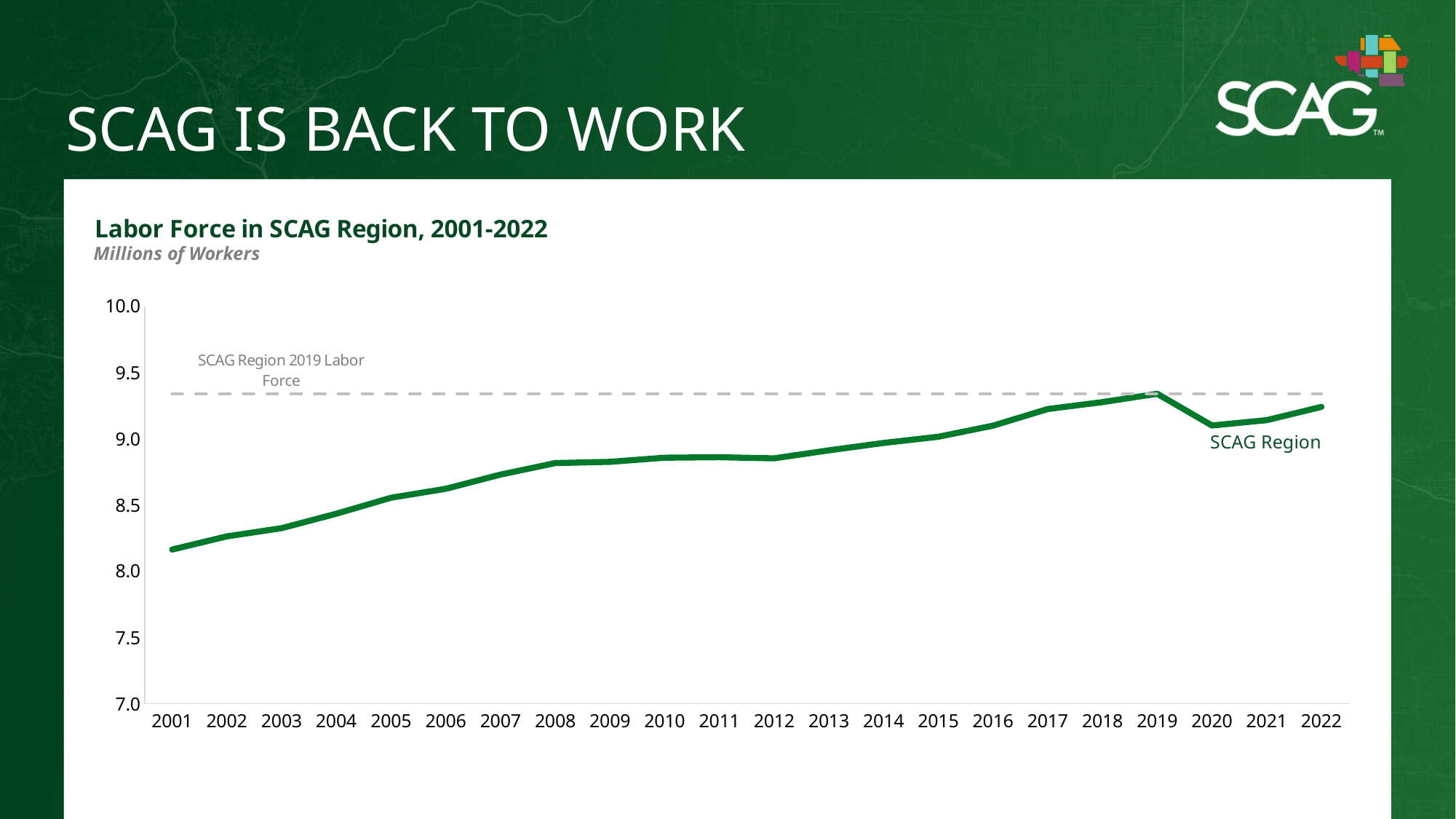
What kind of chart is shown on the slide? line chart Is the value for 2019 greater or less than 9.0? greater Which year has the larger labor force, 2019 or 2020? 2019 How many years are shown on the x axis of the chart? 22 What does the dashed horizontal line on the chart represent? SCAG Region 2019 Labor Force Is the value for 2022 greater or less than 9.5? less Is the value for 2012 greater or less than 9.0? less Does the labor force rise or fall from 2001 to 2019? rise What is the title of the chart? Labor Force in SCAG Region, 2001-2022 In which year does the labor force reach its highest value? 2019 In which year is the labor force at its lowest value? 2001